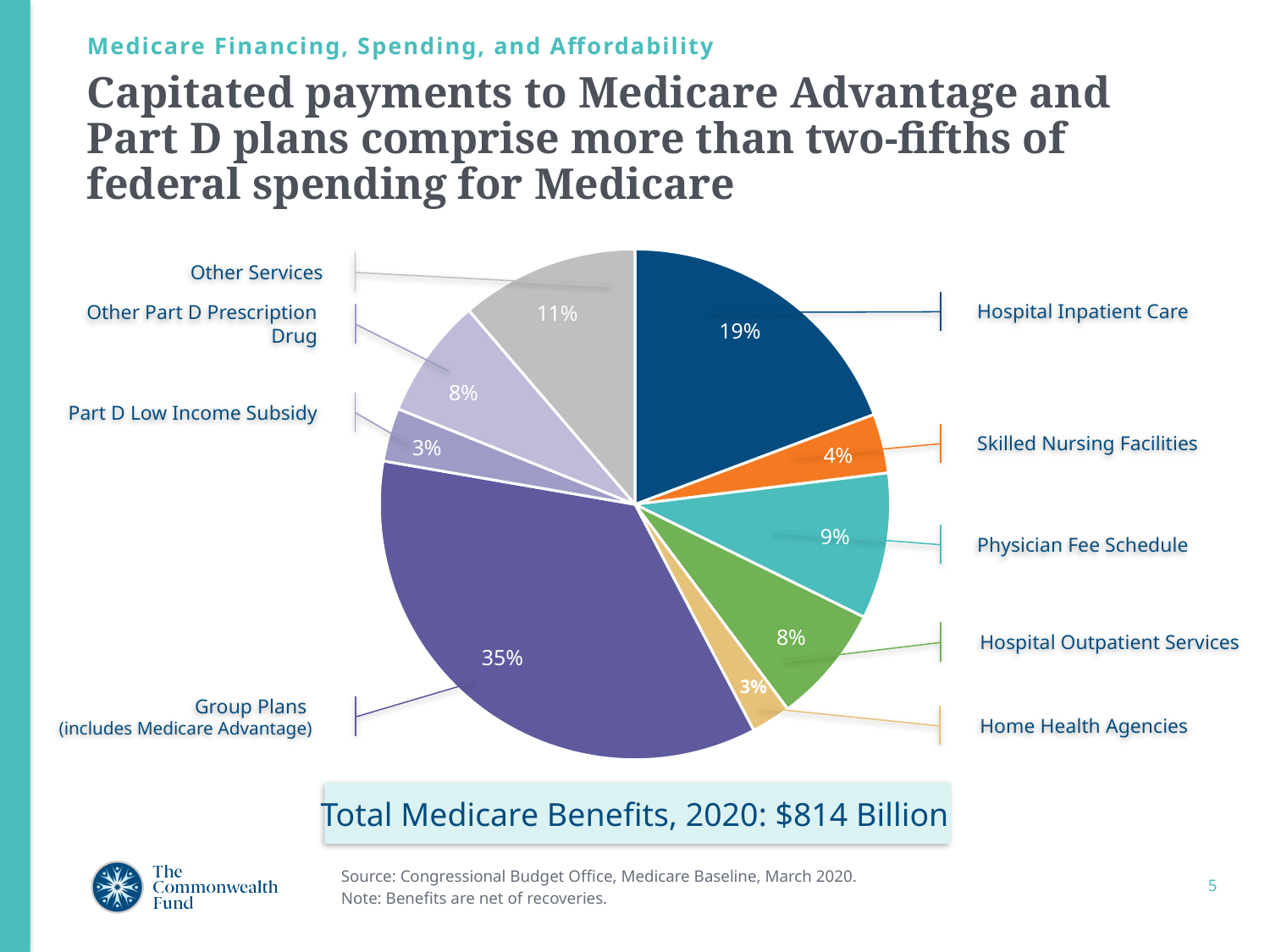
Which is larger, the share for Physician Fee Schedule or the share for Hospital Outpatient Services? Physician Fee Schedule What share is shown for Other Services? 11% What share of Medicare benefits goes to Group Plans (includes Medicare Advantage)? 35% What is the source cited for the chart data? Congressional Budget Office, Medicare Baseline, March 2020 What kind of chart is shown on the slide? Pie chart What is the total Medicare benefits figure for 2020 shown below the chart? $814 Billion What percentage is labeled for Skilled Nursing Facilities? 4% Which category has the largest slice of the pie? Group Plans (includes Medicare Advantage) What share of the pie is Physician Fee Schedule? 9% What is the difference in percentage points between Group Plans and Hospital Inpatient Care? 16 percentage points What percentage of the pie is Hospital Inpatient Care? 19% How many slices does the pie chart have? 9